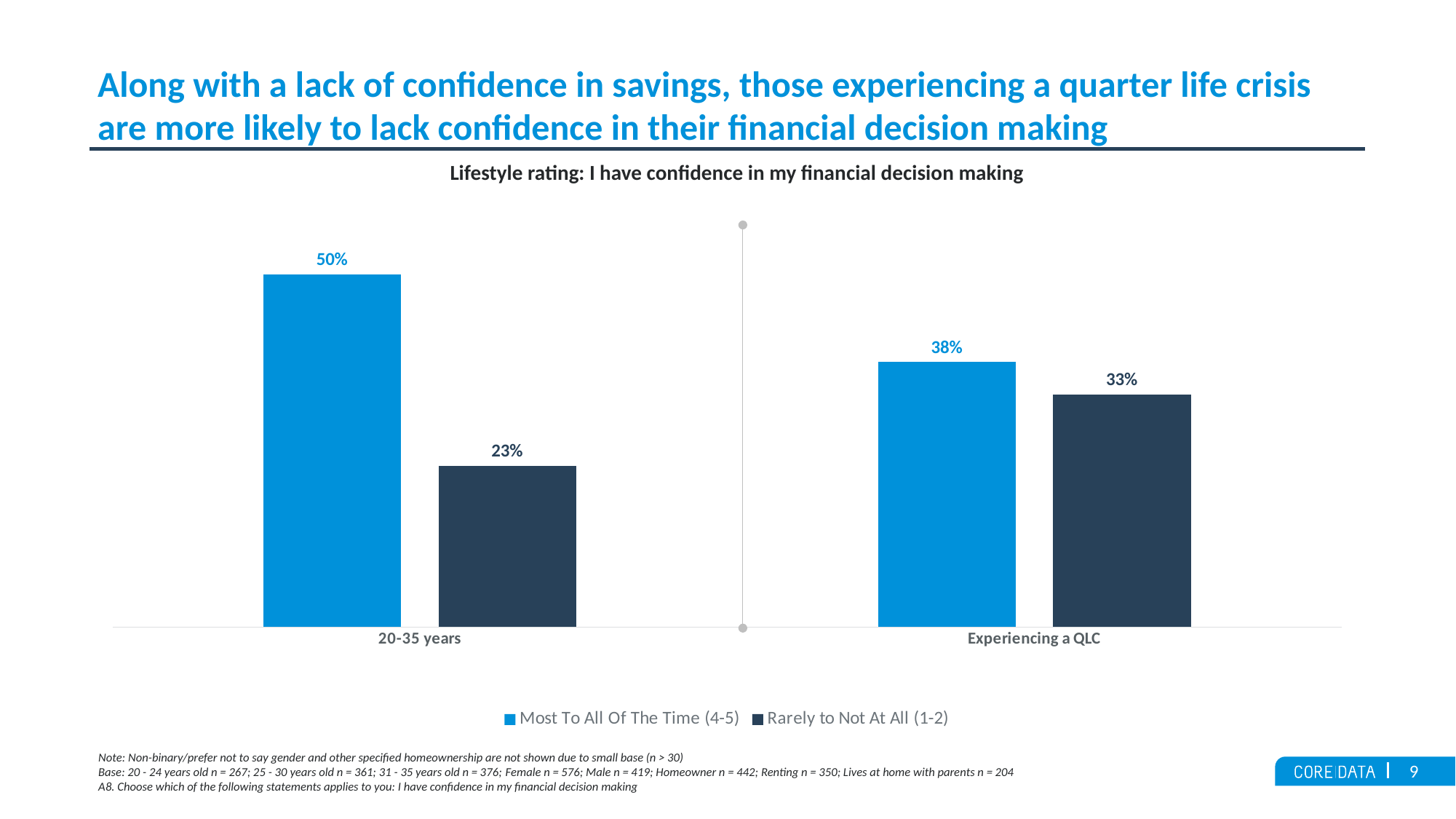
How many categories are shown on the x axis? 2 What is the value for 'Most To All Of The Time (4-5)' for 20-35 years? 50% What is the value for 'Most To All Of The Time (4-5)' for Experiencing a QLC? 38% Which category has the highest 'Most To All Of The Time (4-5)' value? 20-35 years What kind of chart is shown on the slide? Bar chart What is the difference between the 'Most To All Of The Time (4-5)' values for 20-35 years and Experiencing a QLC? 12% Which category has the lowest 'Rarely to Not At All (1-2)' value? 20-35 years How many series does the legend list? 2 What is the value for 'Rarely to Not At All (1-2)' for Experiencing a QLC? 33% What is the value for 'Rarely to Not At All (1-2)' for 20-35 years? 23% What is the difference between the 'Most To All Of The Time (4-5)' and 'Rarely to Not At All (1-2)' values for Experiencing a QLC? 5% Which is larger for Experiencing a QLC: 'Most To All Of The Time (4-5)' or 'Rarely to Not At All (1-2)'? Most To All Of The Time (4-5)